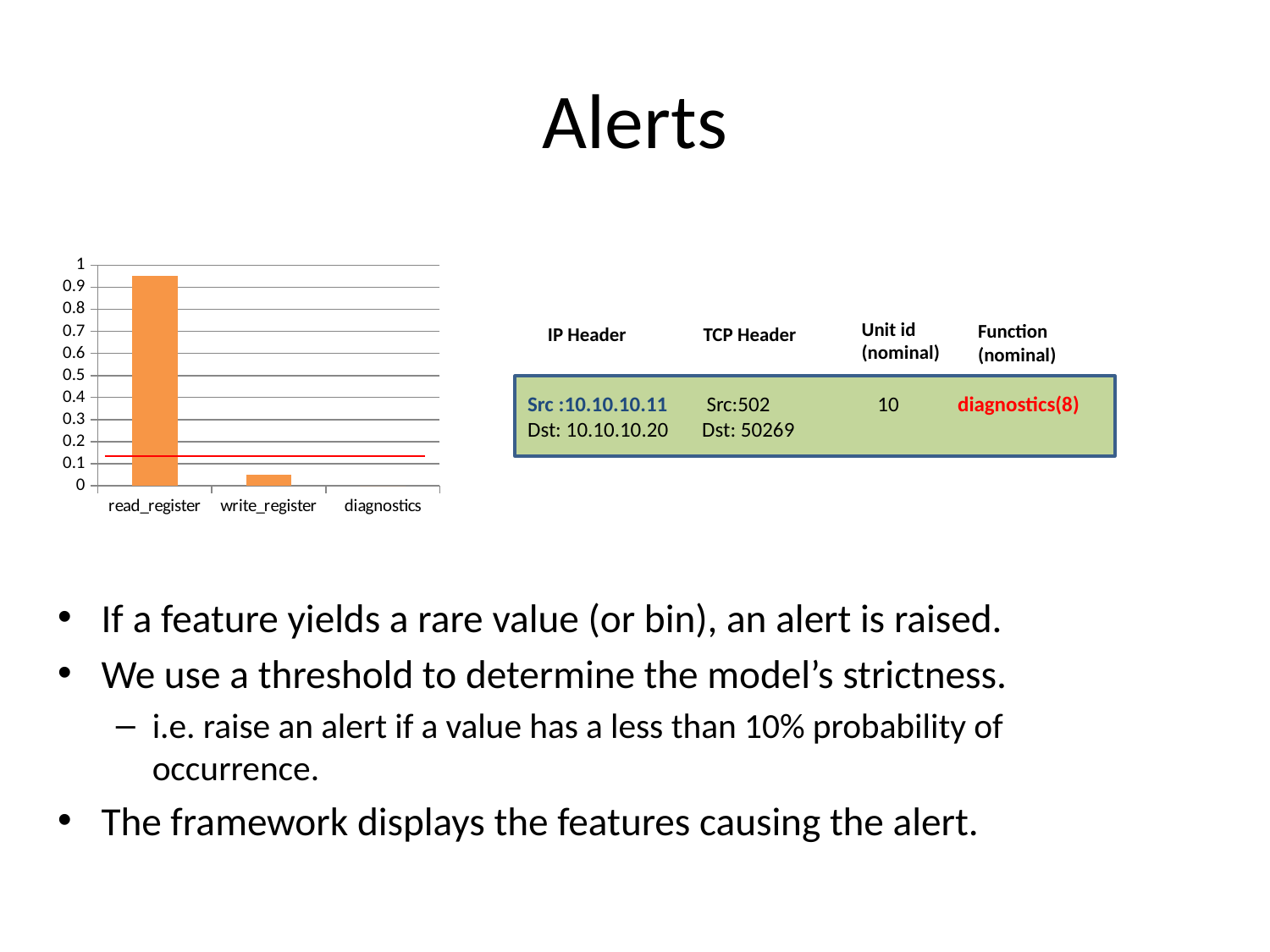
Which is larger, the value for read_register or the value for write_register? read_register What colour are the bars in the chart? orange What is the highest tick value shown on the y axis of the chart? 1 Is the value for write_register greater or less than 0.1? less Which category has the lowest value in the chart? diagnostics Is the value for read_register greater or less than 0.5? greater Is the value for read_register greater or less than 0.9? greater What kind of chart is shown on the slide? bar chart Do the bar values rise or fall moving from left to right along the x axis? fall Which category has the highest bar in the chart? read_register How many categories are shown on the x axis of the chart? 3